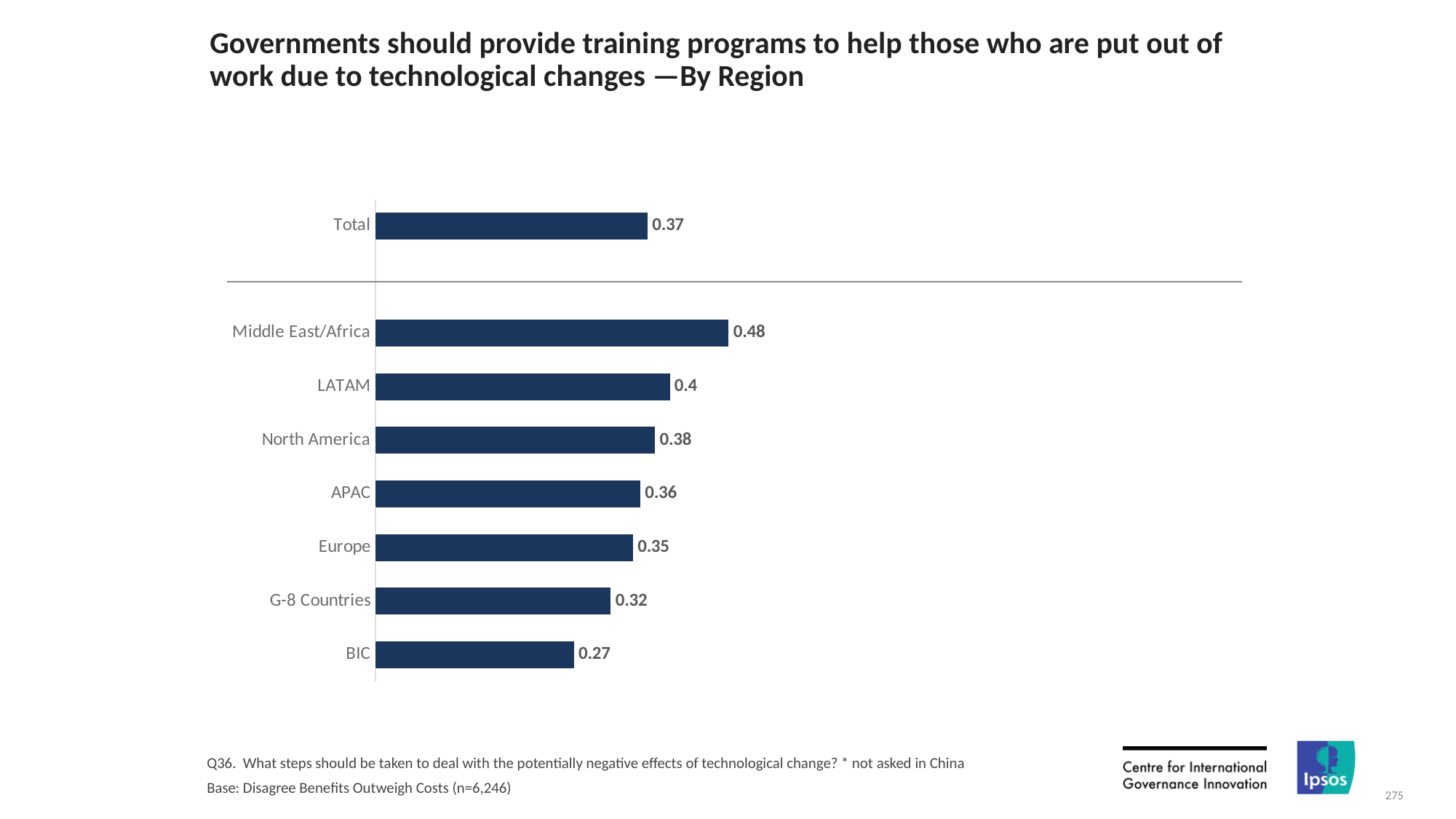
What is the value for G-8 Countries? 0.32 What is the difference between the values for Middle East/Africa and BIC? 0.21 What kind of chart is shown on the slide? Bar chart Which category has the lowest value? BIC What is the difference between the values for LATAM and Europe? 0.05 What is the value for Middle East/Africa? 0.48 How many bars are shown in the chart, including Total? 8 Do the values rise or fall going down the list of regions from Middle East/Africa to BIC? Fall Which region has the highest value? Middle East/Africa What is the value for BIC? 0.27 What is the value for the Total bar? 0.37 Which has a larger value, North America or APAC? North America